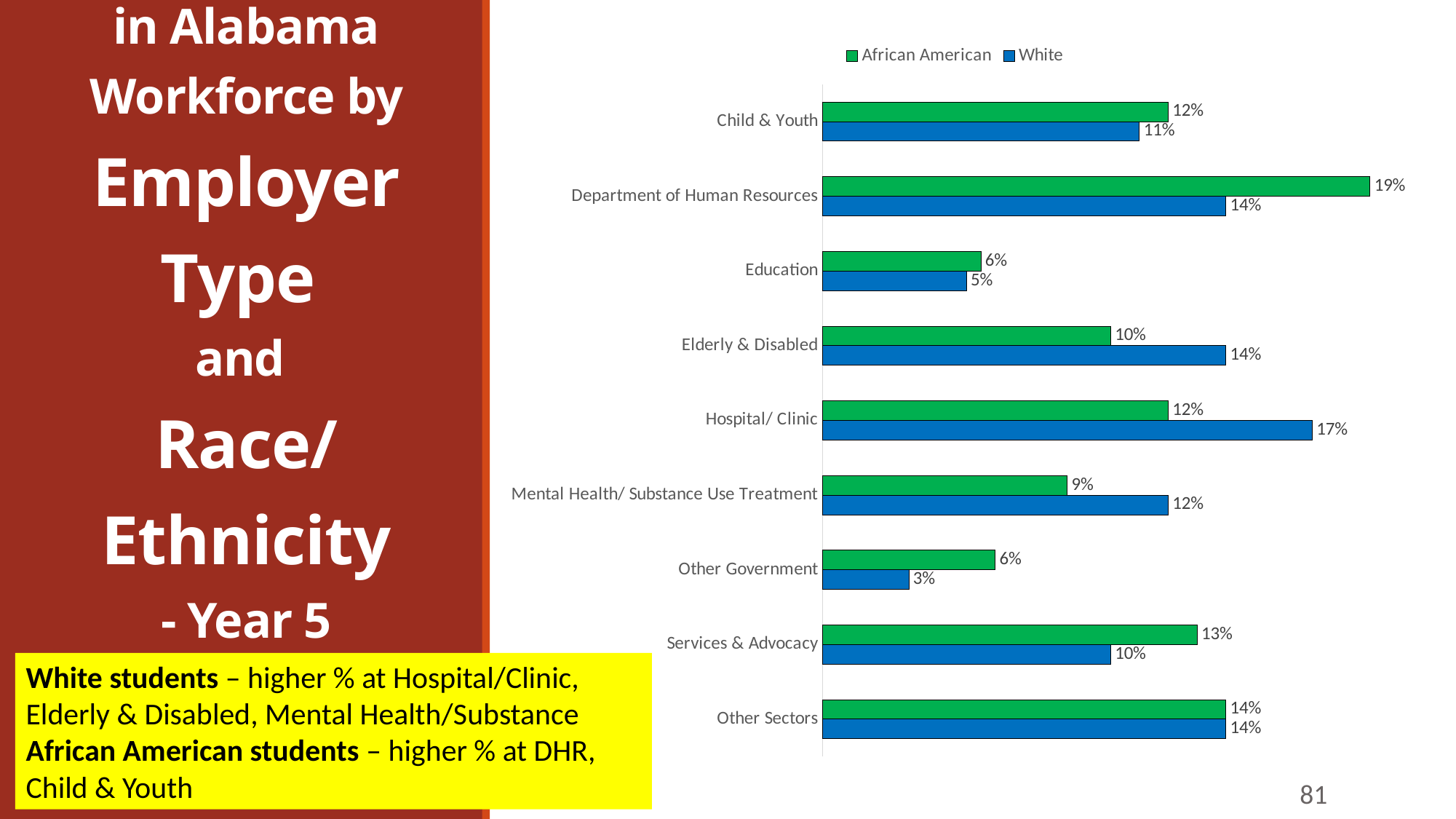
What kind of chart is shown on the slide? Bar chart How many employer type categories are shown on the chart? 9 What is the difference between the White and African American values for Hospital/ Clinic? 5% Which is larger for Elderly & Disabled, the African American value or the White value? White Which category has the highest African American value? Department of Human Resources What is the difference between the African American and White values for Department of Human Resources? 5% Which category has the lowest White value? Other Government What is the African American value for Department of Human Resources? 19% What is the White value for Other Government? 3% What is the White value for Hospital/ Clinic? 17% How many series does the legend list? 2 What is the African American value for Services & Advocacy? 13%